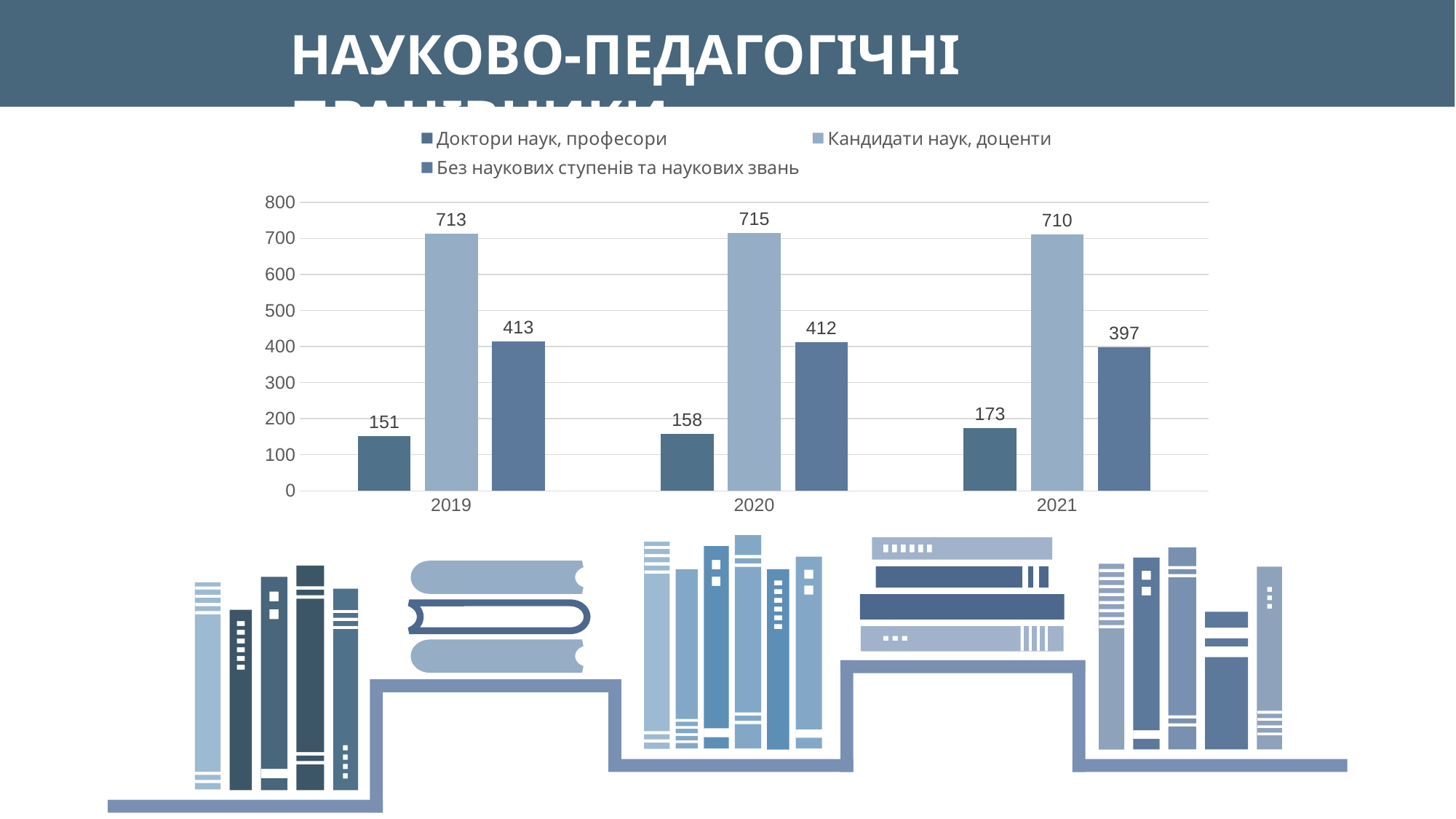
What is the value for Доктори наук, професори in 2019? 151 How many series does the legend list? 3 In which year is the value for Доктори наук, професори the highest? 2021 What is the difference between Кандидати наук, доценти and Без наукових ступенів та наукових звань in 2019? 300 Which is larger in 2020: Доктори наук, професори or Без наукових ступенів та наукових звань? Без наукових ступенів та наукових звань In which year is the value for Без наукових ступенів та наукових звань the lowest? 2021 Which legend entry is shown with the lightest colour? Кандидати наук, доценти Does the value for Доктори наук, професори rise or fall from 2019 to 2021? rise How many year categories are shown on the x axis? 3 What type of chart is shown on the slide? bar chart What is the value for Кандидати наук, доценти in 2020? 715 What is the value for Без наукових ступенів та наукових звань in 2021? 397